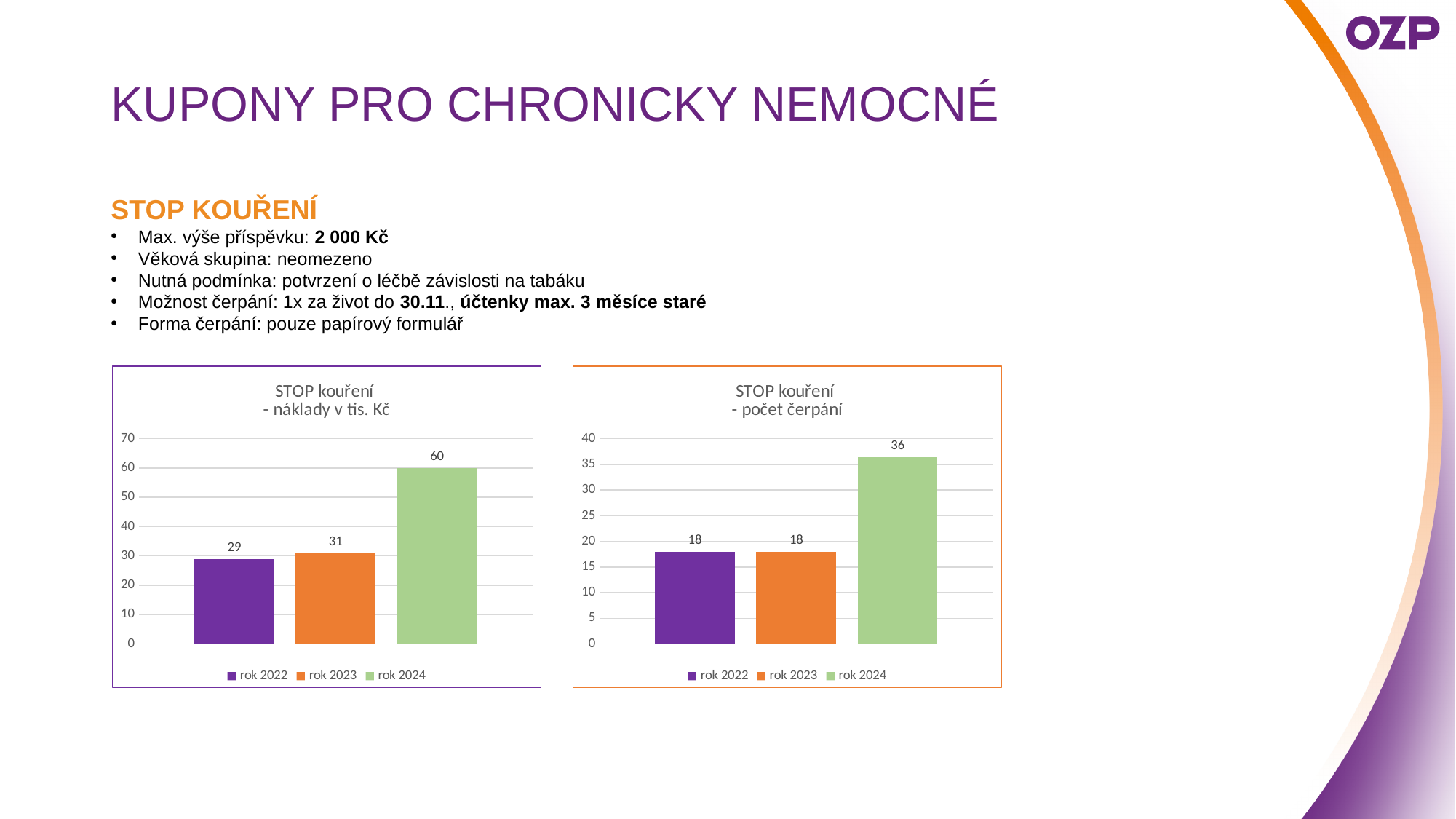
In the chart 'STOP kouření - náklady v tis. Kč', what is the difference between rok 2024 and rok 2023? 29 In the chart 'STOP kouření - náklady v tis. Kč', what is the value for rok 2024? 60 In the chart 'STOP kouření - počet čerpání', how many series does the legend list? 3 In the chart 'STOP kouření - náklady v tis. Kč', is the value for rok 2023 greater or less than 40? less In the chart 'STOP kouření - počet čerpání', what is the difference between rok 2024 and rok 2022? 18 In the chart 'STOP kouření - počet čerpání', what colour is the bar for rok 2023? orange In the chart 'STOP kouření - počet čerpání', which is larger, rok 2024 or rok 2022? rok 2024 In the chart 'STOP kouření - počet čerpání', what is the value for rok 2023? 18 What kind of chart is 'STOP kouření - náklady v tis. Kč'? bar chart In the chart 'STOP kouření - náklady v tis. Kč', what is the value for rok 2022? 29 In the chart 'STOP kouření - počet čerpání', what is the value for rok 2024? 36 In the chart 'STOP kouření - náklady v tis. Kč', which year has the highest value? rok 2024